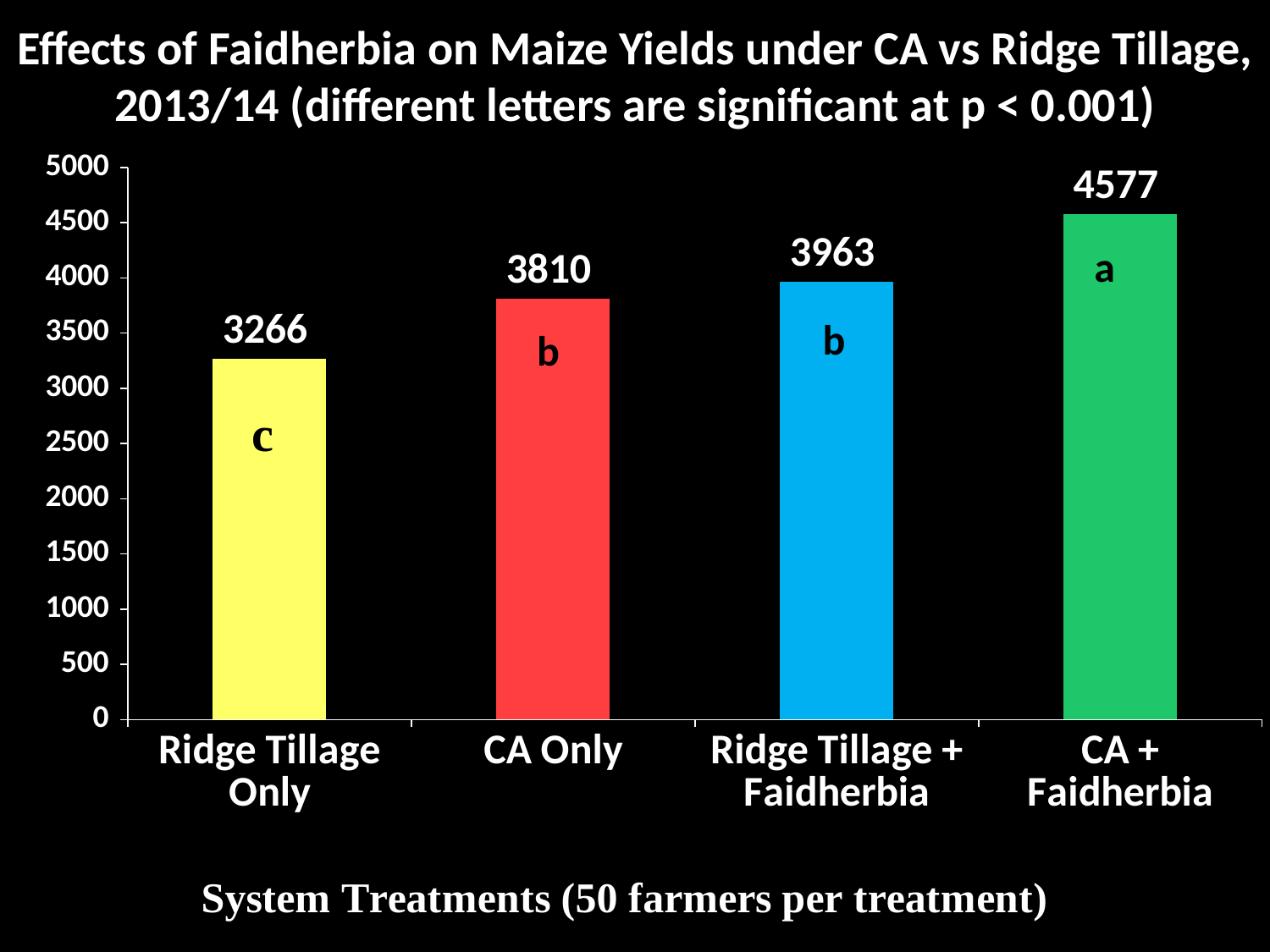
What kind of chart is shown on the slide? bar chart What is the maize yield for CA + Faidherbia? 4577 How many treatments are shown on the chart? 4 Is the value for CA Only greater or less than 4000? less Which has a higher yield, CA Only or Ridge Tillage + Faidherbia? Ridge Tillage + Faidherbia Which treatment has the lowest maize yield? Ridge Tillage Only What is the difference in yield between CA Only and Ridge Tillage Only? 544 What is the value shown for Ridge Tillage + Faidherbia? 3963 What is the maize yield for Ridge Tillage Only? 3266 What is the difference in yield between CA + Faidherbia and Ridge Tillage Only? 1311 Which treatment has the highest maize yield? CA + Faidherbia What significance letter is shown on the CA + Faidherbia bar? a